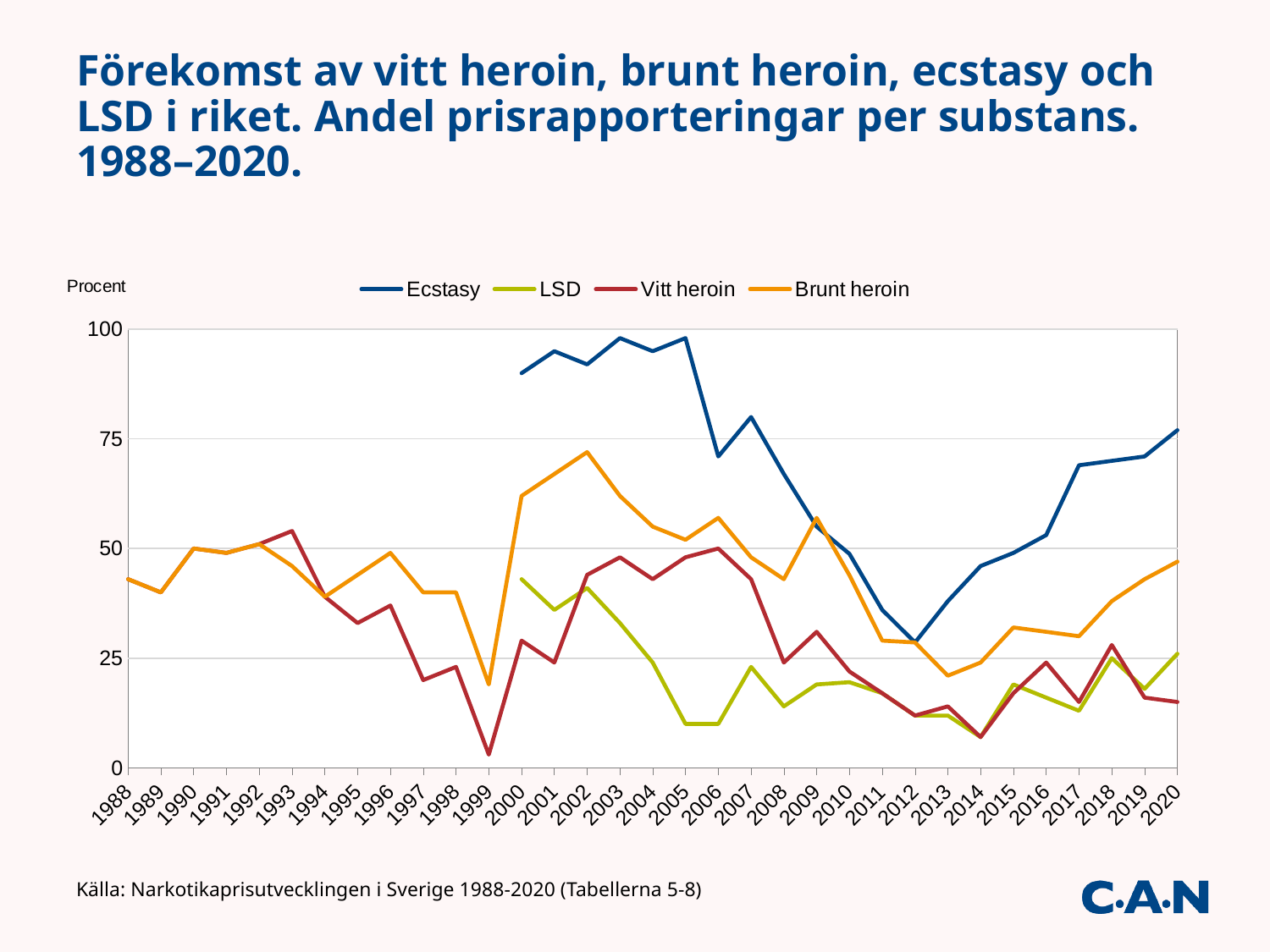
Which series has the highest value in 2003? Ecstasy Does the Ecstasy line rise or fall from 2005 to 2012? Falls Is the value for LSD in 2000 greater or less than 50? less Is the value for Ecstasy in 2003 greater or less than 75? greater What kind of chart is shown on the slide? Line chart In 2009, which is larger: LSD or Vitt heroin? Vitt heroin Is the value for Vitt heroin in 1999 greater or less than 25? less In 2020, which is larger: Ecstasy or Brunt heroin? Ecstasy How many years are shown along the x axis? 33 How many series does the legend list? 4 Which series has the lowest value in 2005? LSD